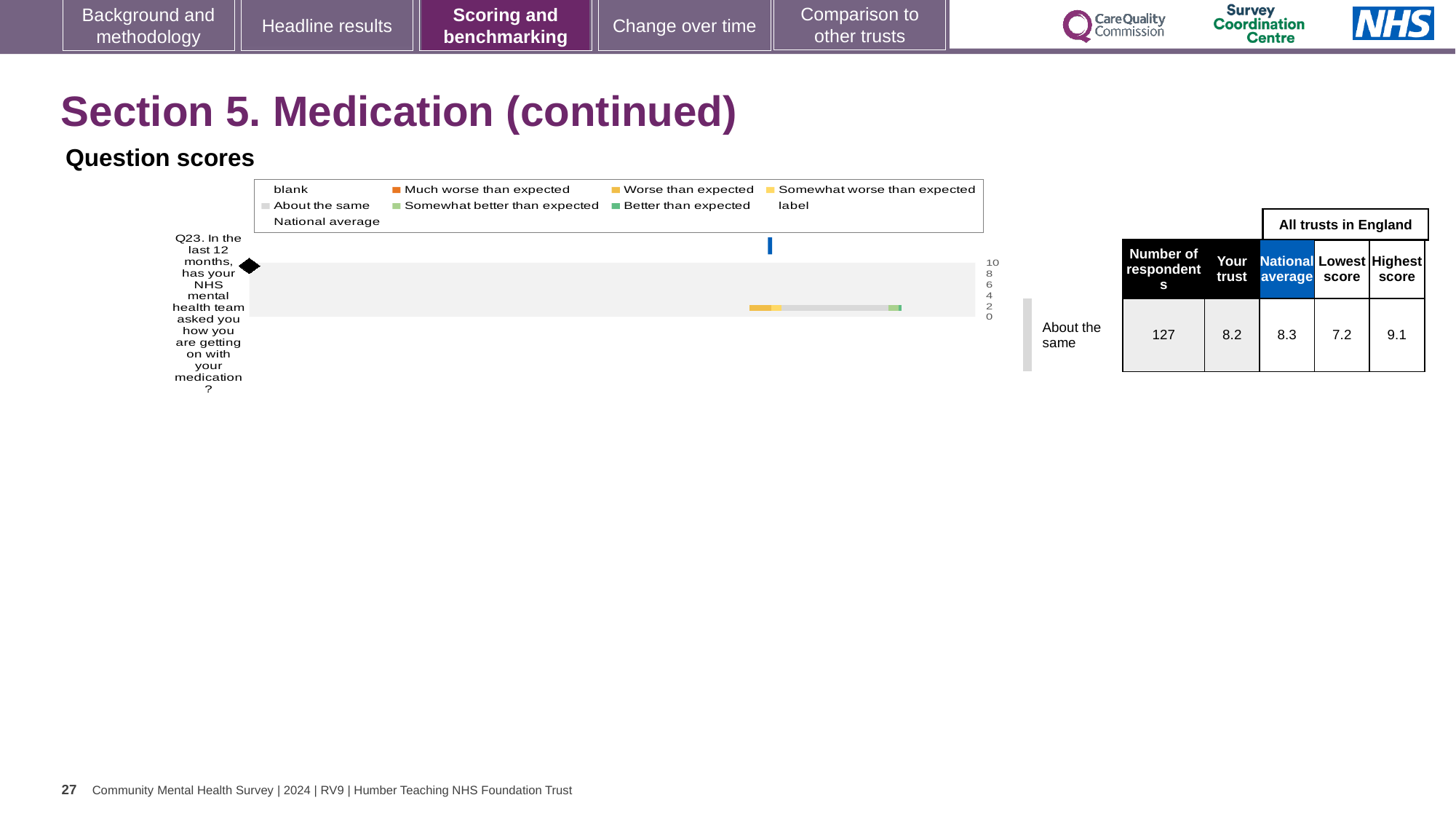
What is the national average score for Q23 in the table beside the chart? 8.3 What is the 'Your trust' score for Q23 in the table beside the chart? 8.2 Which is larger for Q23, the 'Your trust' score or the national average? National average What is the lowest score among all trusts in England for Q23? 7.2 What is the highest value shown on the chart's score axis? 10 What kind of chart is shown under 'Question scores'? bar chart How many respondents answered Q23 according to the table beside the chart? 127 What is the difference between the highest score and the lowest score for Q23? 1.9 How many questions are plotted on the chart? 1 What benchmark category is Q23 assigned to on the slide? About the same What is the highest score among all trusts in England for Q23? 9.1 Which colour does the legend use for 'Much worse than expected'? orange